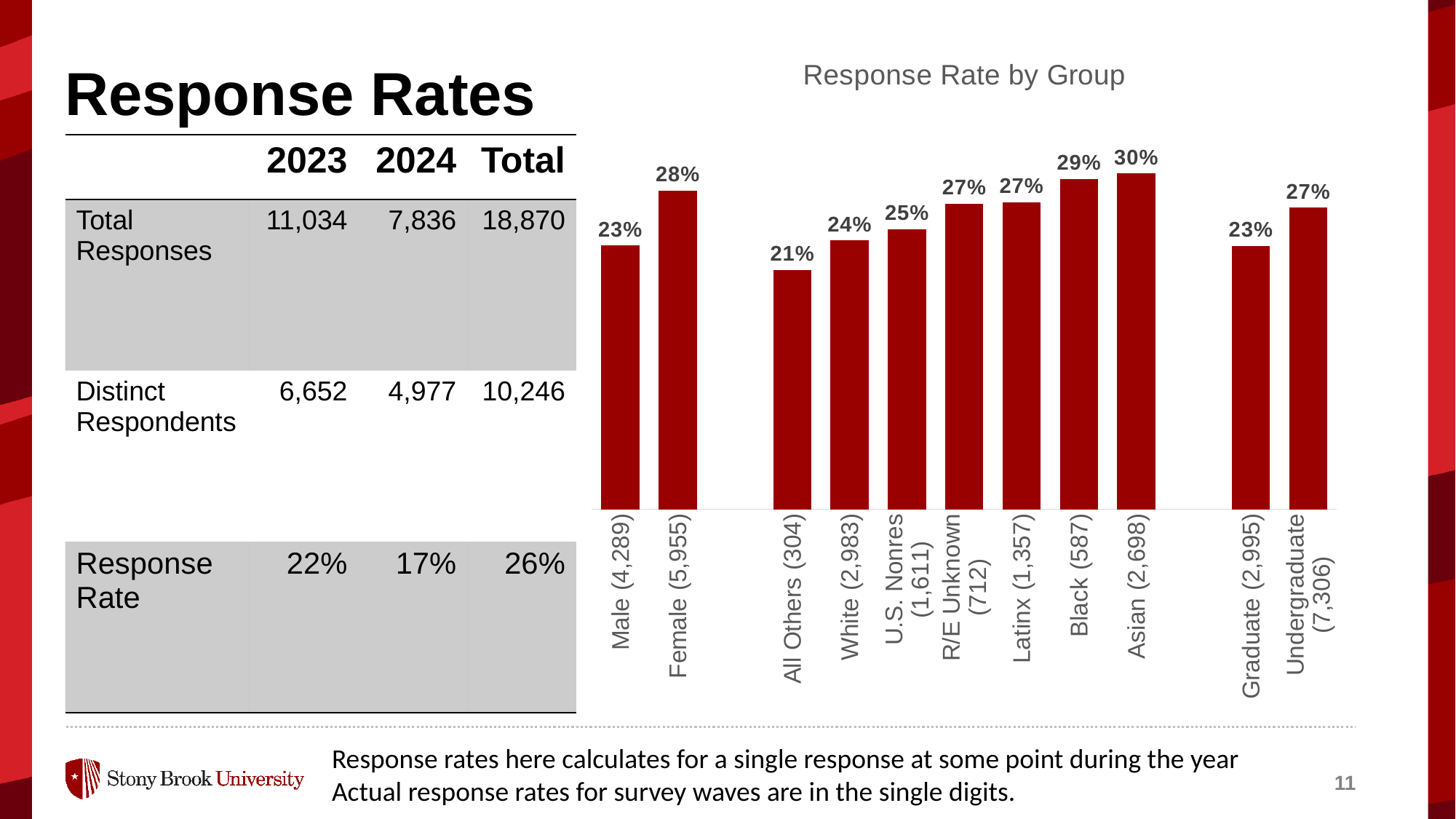
What is the difference between the response rates for Asian (2,698) and All Others (304)? 9% What is the difference between the response rates for Female (5,955) and Male (4,289)? 5% What is the title of the chart on the slide? Response Rate by Group What type of chart is the Response Rate by Group chart? Bar chart How many groups are shown as bars in the Response Rate by Group chart? 11 What is the response rate for Female (5,955) in the Response Rate by Group chart? 28% Which group has the lowest response rate in the Response Rate by Group chart? All Others (304) What is the response rate for All Others (304) in the Response Rate by Group chart? 21% Which has a higher response rate, Undergraduate (7,306) or Graduate (2,995)? Undergraduate (7,306) Which has a higher response rate, Black (587) or White (2,983)? Black (587) What is the response rate for Undergraduate (7,306) in the Response Rate by Group chart? 27% Which group has the highest response rate in the Response Rate by Group chart? Asian (2,698)